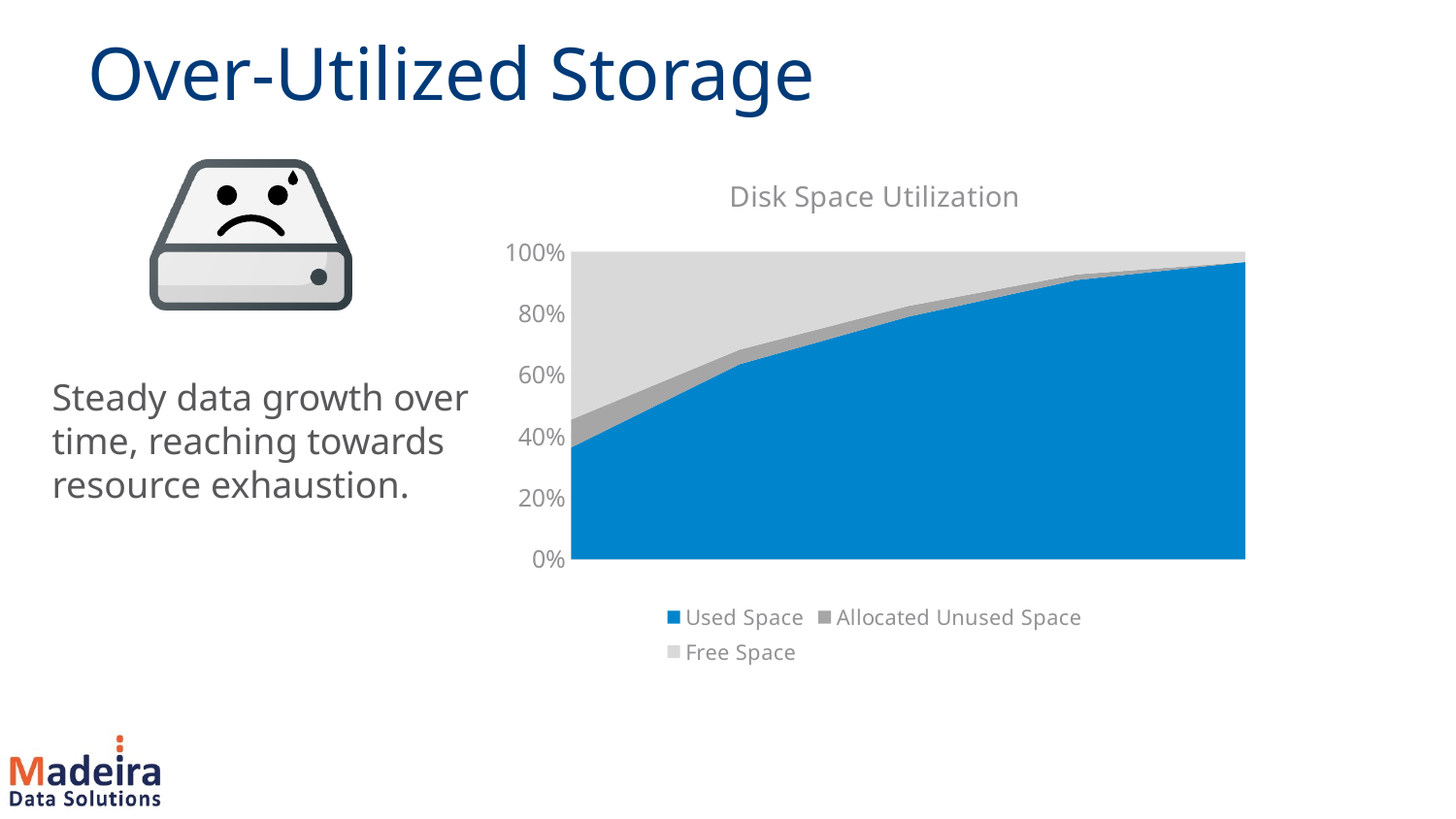
At the right end of the chart, is the share of Free Space greater or less than 20%? less At the left end of the chart, is the value for Used Space greater or less than 60%? less What kind of chart is shown on the slide? area chart Does the Used Space series rise or fall along the x axis? rise What is the highest value shown on the chart's vertical axis? 100% At the right end of the chart, is the value for Used Space greater or less than 80%? greater What is the title of the chart? Disk Space Utilization How many series does the chart's legend list? 3 Does the Free Space series rise or fall along the x axis? fall Which series is shown in blue in the chart? Used Space